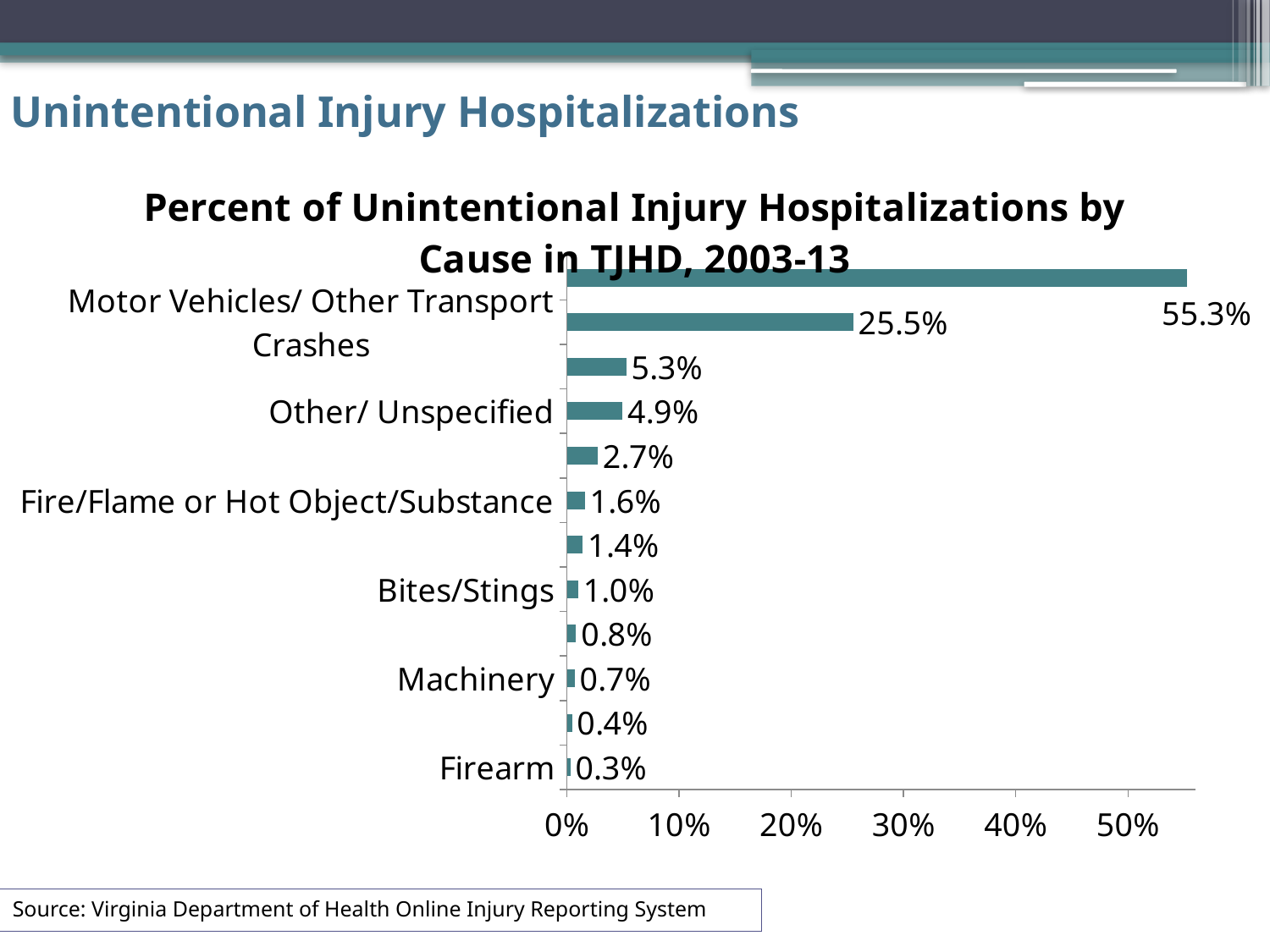
What percent of unintentional injury hospitalizations is attributed to Motor Vehicles/ Other Transport Crashes? 25.5% How many bars are plotted in the chart? 12 Which labeled cause has the lowest percentage? Firearm What is the title of the chart? Percent of Unintentional Injury Hospitalizations by Cause in TJHD, 2003-13 What is the difference between the values for Motor Vehicles/ Other Transport Crashes and Other/ Unspecified? 20.6% What is the value for Machinery? 0.7% What is the value for Bites/Stings? 1.0% What is the value for Other/ Unspecified? 4.9% What is the value for Firearm? 0.3% What is the value for Fire/Flame or Hot Object/Substance? 1.6% What kind of chart is shown on the slide? bar chart What is the largest value shown on the chart? 55.3%